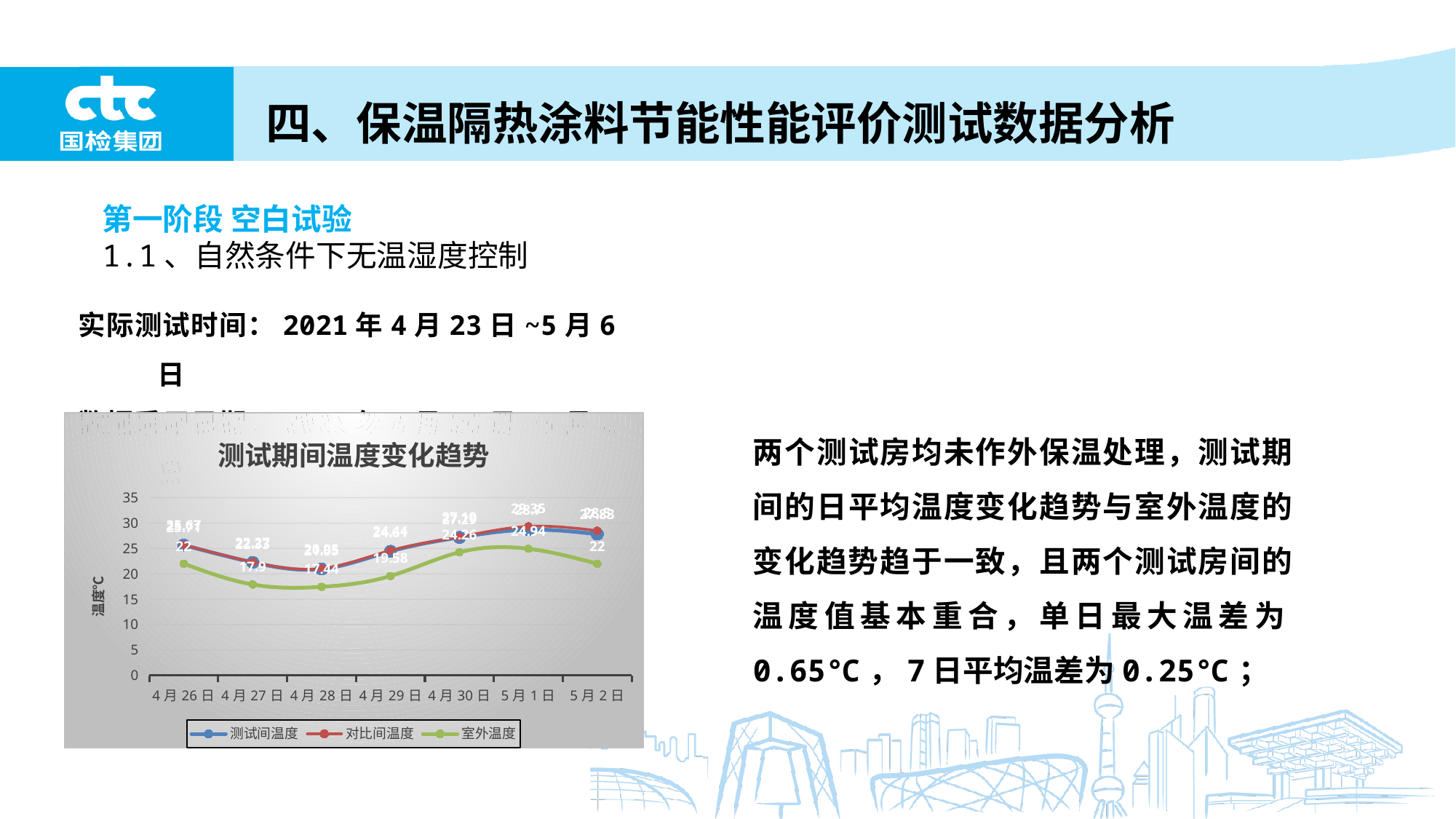
What is the title of the chart? 测试期间温度变化趋势 Does the 室外温度 rise or fall from 4月26日 to 4月28日? fall How many dates are plotted along the x axis of the chart? 7 On which date is the 室外温度 highest? 5月1日 How many series does the chart legend list? 3 On which date is the 室外温度 lowest? 4月28日 What is the 室外温度 value on 4月30日? 24.26 What is the 室外温度 value on 4月28日? 17.44 Is the 测试间温度 value on 5月1日 greater or less than 25? greater What is the difference between the 室外温度 on 4月30日 and on 4月28日? 6.82 What is the 室外温度 value on 4月27日? 17.9 What kind of chart is shown on the slide? line chart